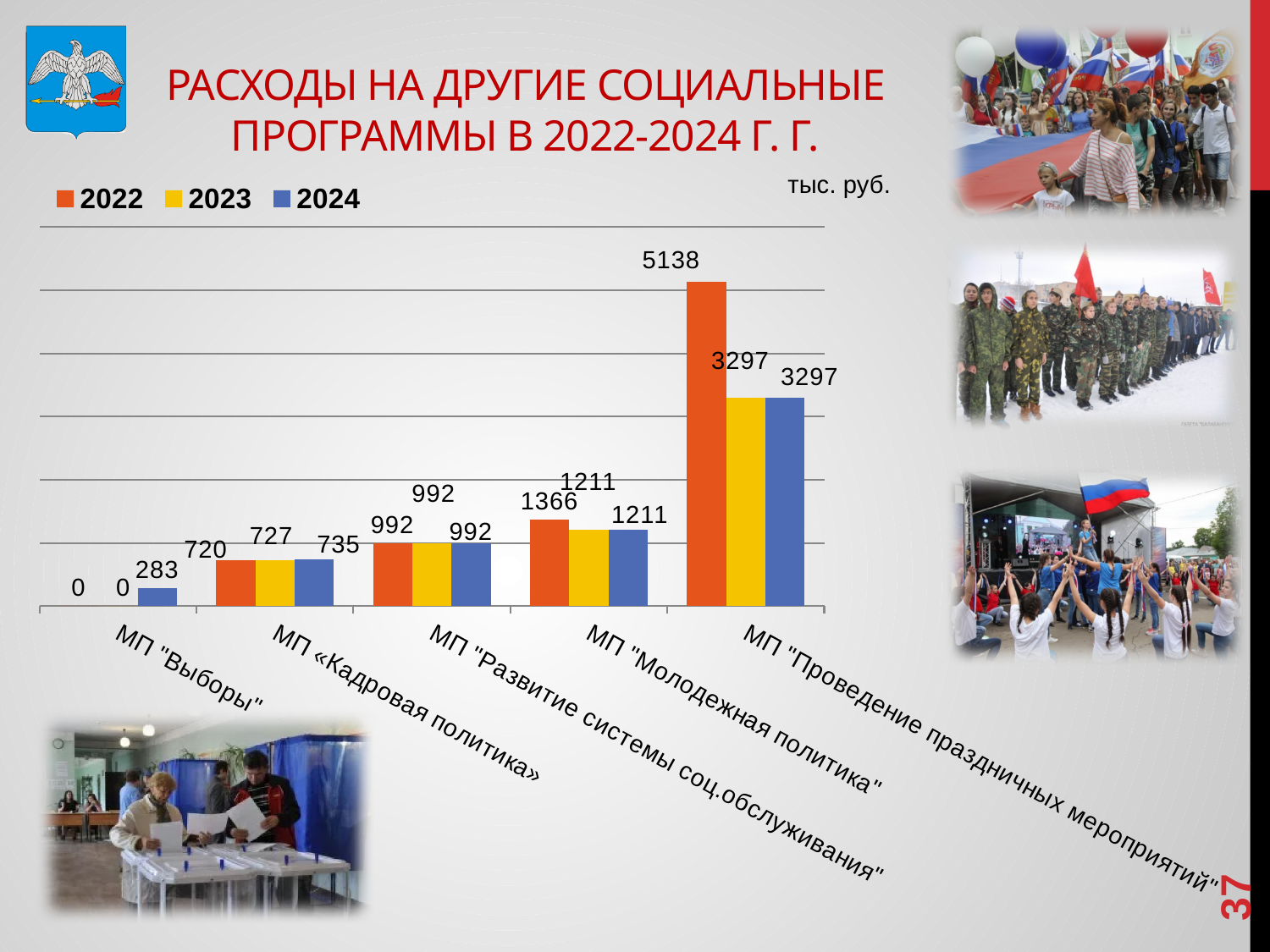
What kind of chart is shown on the slide? Bar chart Which category has the highest value in 2022? МП "Проведение праздничных мероприятий" Which category has the lowest value in 2024? МП "Выборы" What is the value for МП "Выборы" in 2024? 283 How many categories are shown on the x axis? 5 What is the value for МП «Кадровая политика» in 2023? 727 What is the difference between the 2022 and 2023 values for МП "Проведение праздничных мероприятий"? 1841 What is the value for МП "Молодежная политика" in 2022? 1366 What is the value for МП "Проведение праздничных мероприятий" in 2022? 5138 How many series does the legend list? 3 Which is larger: the 2024 value for МП «Кадровая политика» or the 2024 value for МП "Развитие системы соц.обслуживания"? МП "Развитие системы соц.обслуживания" What is the difference between the 2022 and 2023 values for МП "Молодежная политика"? 155